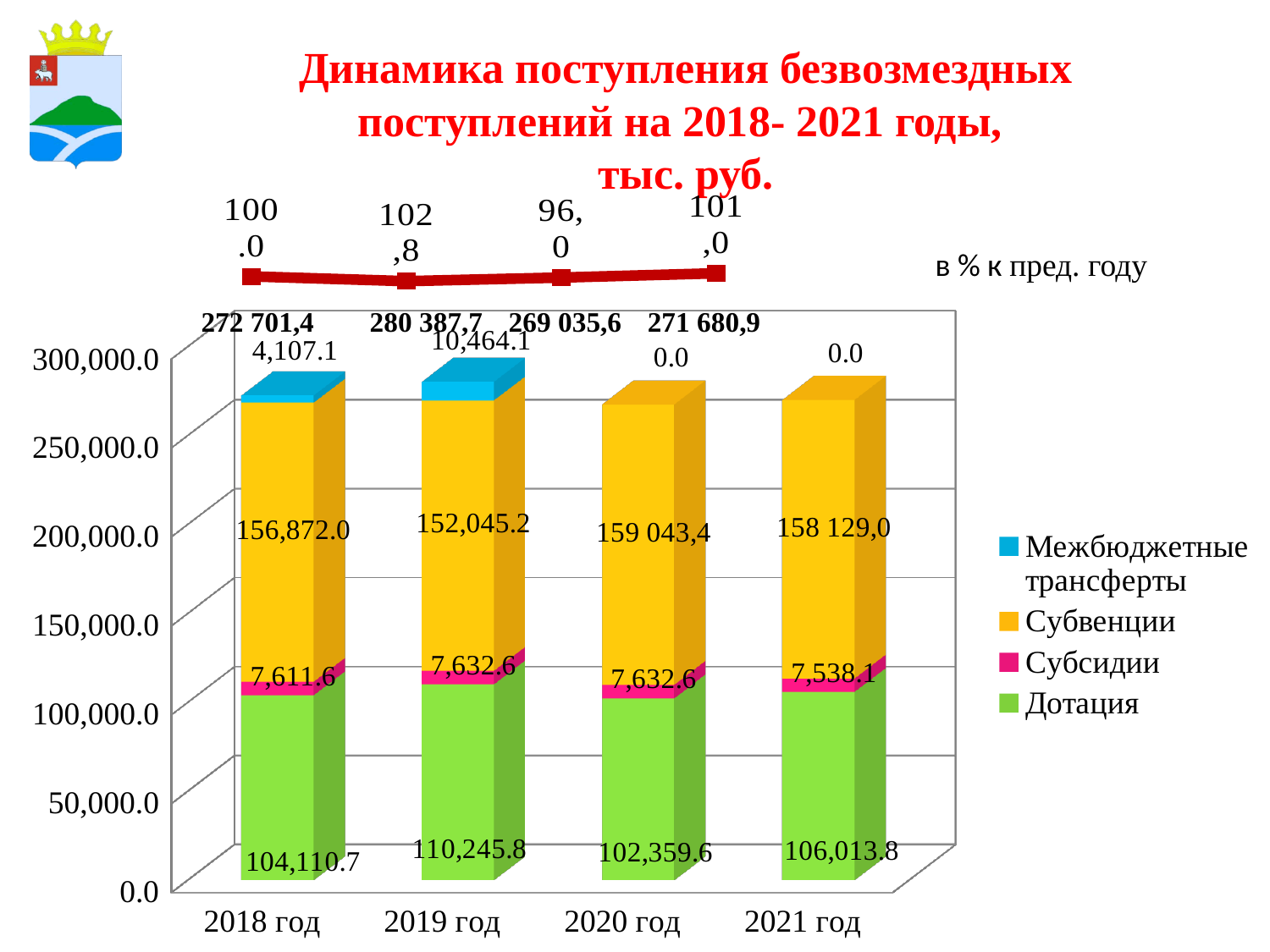
In which year is the Дотация value the highest? 2019 год How many years are shown on the x axis of the bar chart? 4 Which year has the larger Субвенции value, 2018 год or 2019 год? 2018 год What is the value of Дотация for 2019 год? 110,245.8 What is the value of Субсидии for 2021 год? 7,538.1 What is the value of Субвенции for 2020 год? 159 043,4 What is the difference between the Дотация values for 2019 год and 2018 год? 6,135.1 In which year is the Дотация value the lowest? 2020 год What kind of chart is used to show the data by year? Stacked bar chart How many series does the legend of the bar chart list? 4 What is the total of the stacked bar for 2019 год? 280 387,7 What is the value of Межбюджетные трансферты for 2018 год? 4,107.1